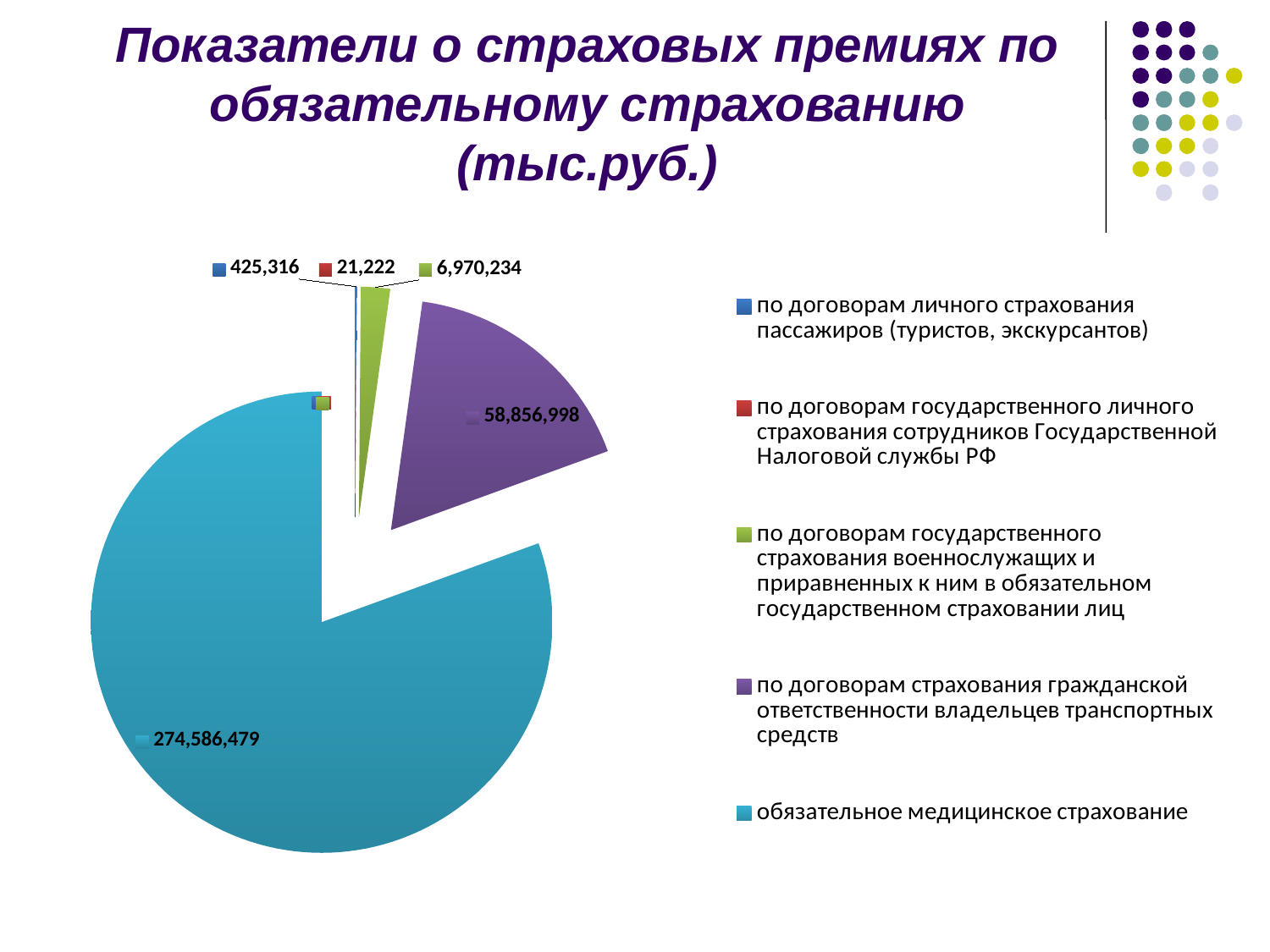
Which is larger: the value for по договорам личного страхования пассажиров (туристов, экскурсантов) or the value for по договорам государственного страхования военнослужащих? по договорам государственного страхования военнослужащих What type of chart is shown on the slide? pie chart What is the value for по договорам государственного личного страхования сотрудников Государственной Налоговой службы РФ? 21,222 What is the title of the chart on the slide? Показатели о страховых премиях по обязательному страхованию (тыс.руб.) Which category has the smallest slice of the pie? по договорам государственного личного страхования сотрудников Государственной Налоговой службы РФ What is the difference between the value for по договорам личного страхования пассажиров (туристов, экскурсантов) and the value for по договорам государственного личного страхования сотрудников Государственной Налоговой службы РФ? 404,094 How many slices does the pie chart have? 5 What is the difference between the value for обязательное медицинское страхование and the value for по договорам страхования гражданской ответственности владельцев транспортных средств? 215,729,481 What is the value for по договорам государственного страхования военнослужащих и приравненных к ним в обязательном государственном страховании лиц? 6,970,234 Which category has the largest slice of the pie? обязательное медицинское страхование What is the value for по договорам страхования гражданской ответственности владельцев транспортных средств? 58,856,998 What is the value for обязательное медицинское страхование? 274,586,479